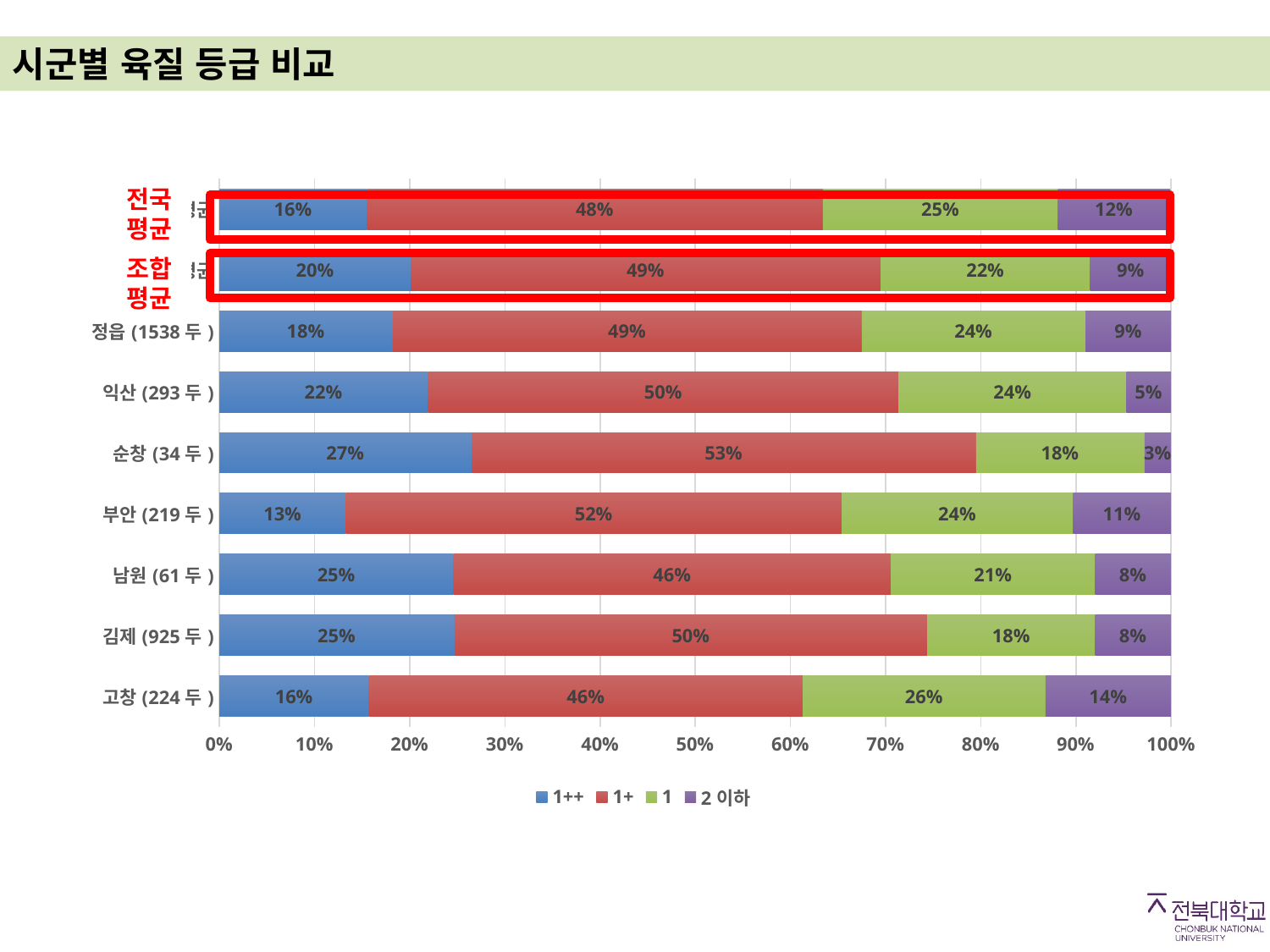
What kind of chart is shown on the slide? Stacked bar chart What is the 2 이하 share for 고창 (224 두)? 14% What is the difference between the 1++ share of 조합 평균 and 전국 평균? 4% Which category has the lowest 1++ share? 부안 (219 두) Which has a larger 1+ share, 순창 (34 두) or 남원 (61 두)? 순창 (34 두) Which category has the highest 1++ share? 순창 (34 두) How many series does the legend list? 4 Which category has the highest 2 이하 share? 고창 (224 두) How many categories (bars) are shown in the chart? 9 What is the 1 grade share for 조합 평균? 22% What is the 1+ share for 전국 평균? 48% What is the 1++ share for 순창 (34 두)? 27%